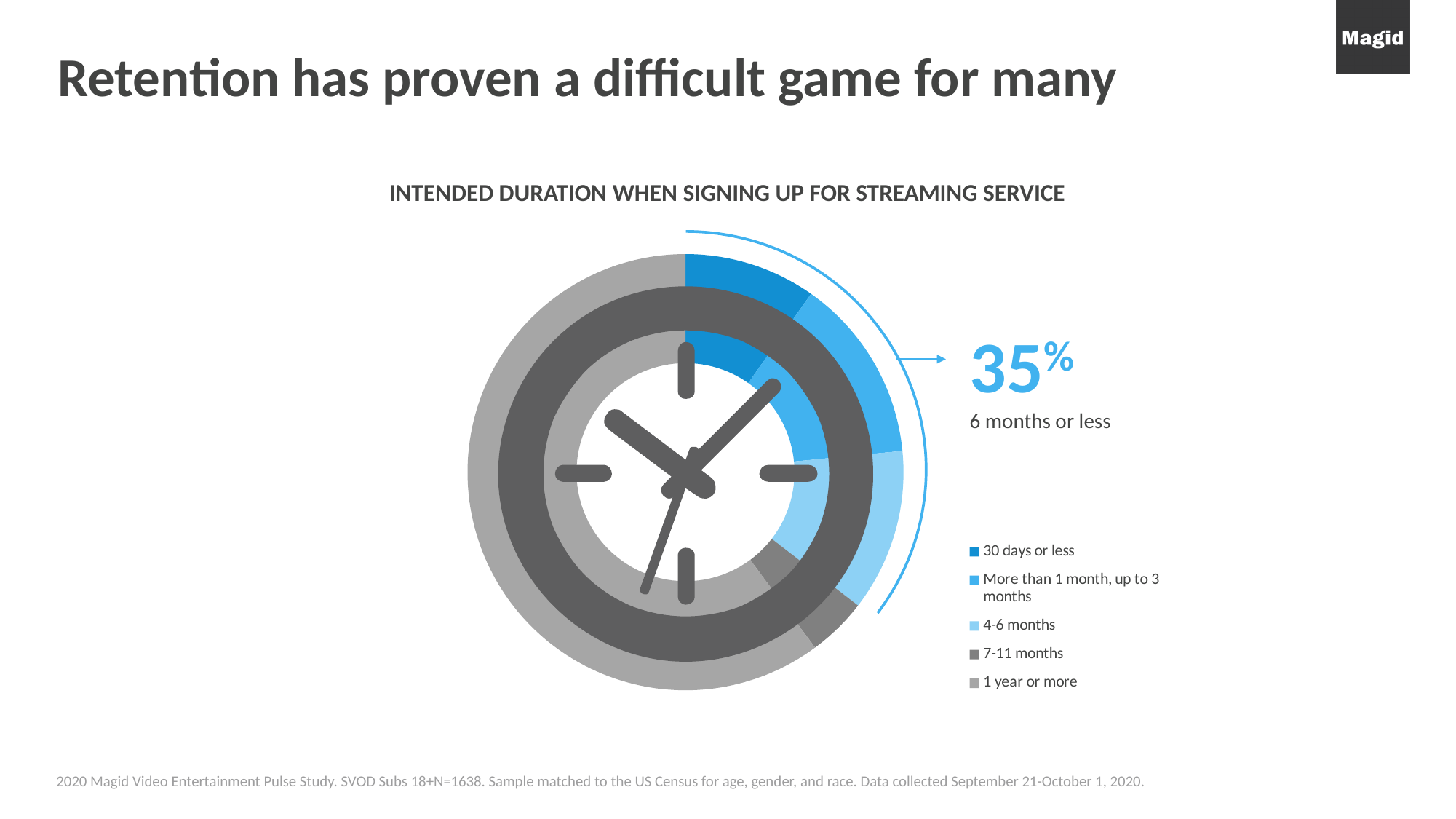
Which category has the largest slice of the donut chart? 1 year or more How many categories does the chart's legend list? 5 Which legend entry is shown in the lightest blue colour? 4-6 months What is the title of the chart? INTENDED DURATION WHEN SIGNING UP FOR STREAMING SERVICE Which is larger: the slice for 'More than 1 month, up to 3 months' or the slice for '7-11 months'? More than 1 month, up to 3 months Which three legend categories make up the '6 months or less' group highlighted at 35%? 30 days or less; More than 1 month, up to 3 months; 4-6 months Is the combined share for '6 months or less' greater or less than 50%? less Which is larger: the slice for '1 year or more' or the slice for '30 days or less'? 1 year or more What kind of chart is shown on the slide? Donut (pie) chart What combined share of respondents intended to sign up for 6 months or less? 35%